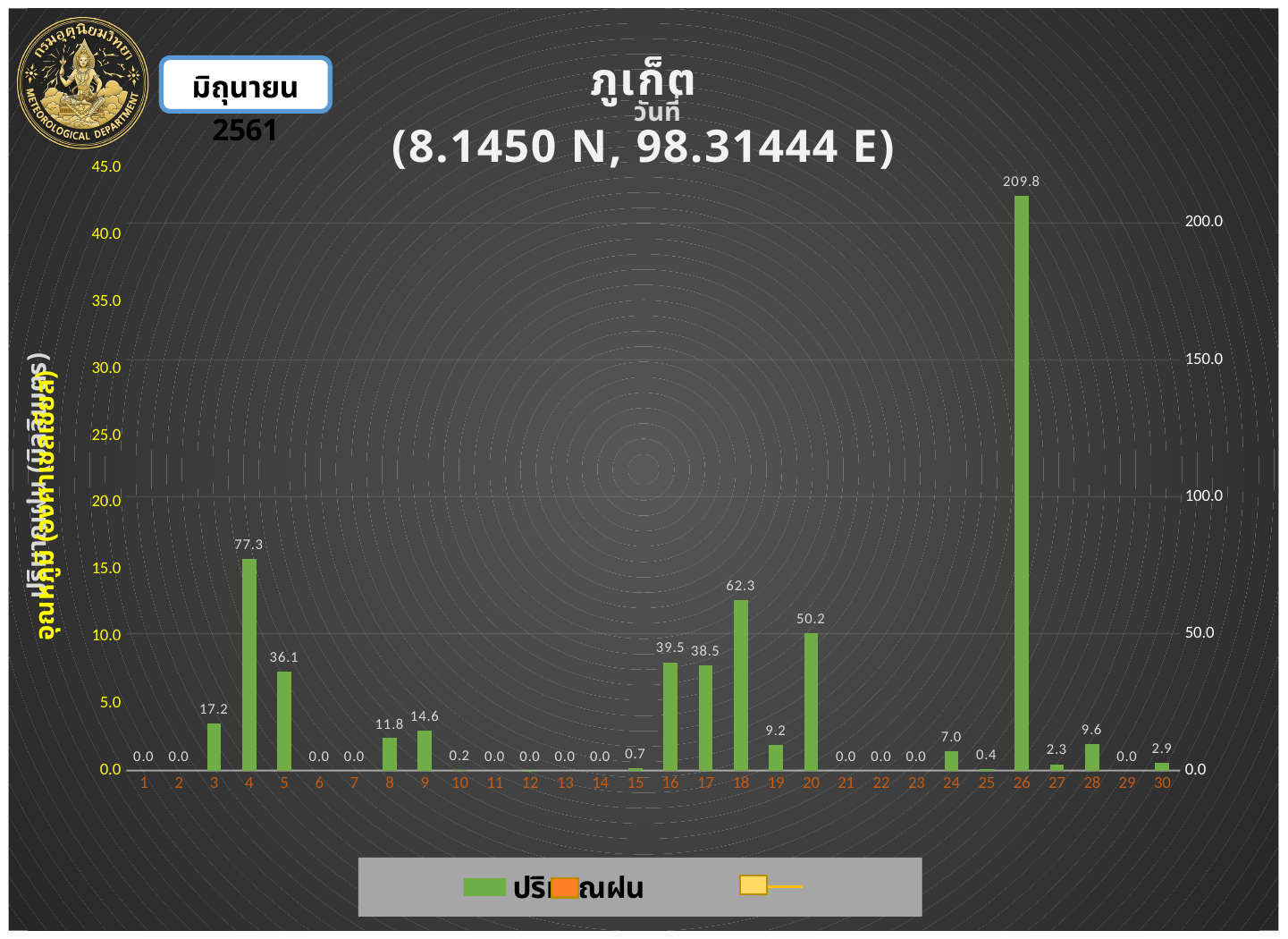
What are the coordinates shown in the chart title? 8.1450 N, 98.31444 E What kind of chart is shown on the slide? bar chart What is the value shown for day 26? 209.8 What is the difference between the values for day 16 and day 17? 1.0 What is the value shown for day 4? 77.3 How many days are shown on the x axis? 30 Which day has the highest value? 26 What is the value shown for day 20? 50.2 Which is larger, the value for day 8 or the value for day 9? day 9 What is the difference between the values for day 4 and day 5? 41.2 Which is larger, the value for day 3 or the value for day 24? day 3 What is the value shown for day 18? 62.3